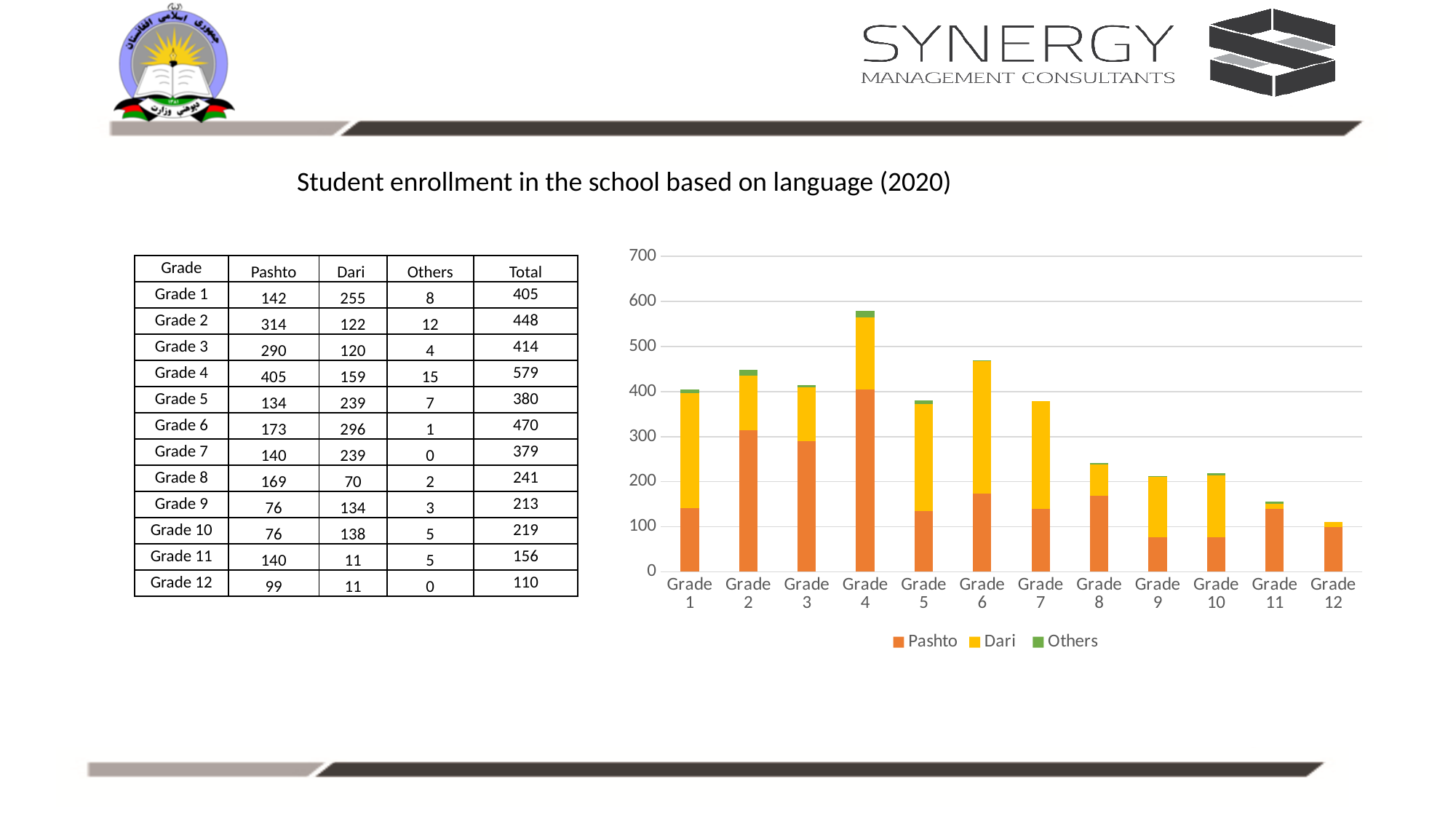
What is the difference between the total enrollment of Grade 4 and Grade 12? 469 Which grade has the tallest stacked bar in the chart? Grade 4 How many series does the chart legend list? 3 Is the total stacked bar for Grade 7 greater or less than 400? less What is the Pashto enrollment for Grade 4? 405 Which grade has the shortest stacked bar in the chart? Grade 12 Which is larger for Grade 1, the Pashto segment or the Dari segment? Dari What is the total enrollment for Grade 2 (the full stacked bar)? 448 Which colour represents the Others series in the chart? green What kind of chart is shown on the slide? stacked bar chart How many grades are plotted along the x axis of the chart? 12 What is the Dari enrollment for Grade 6? 296